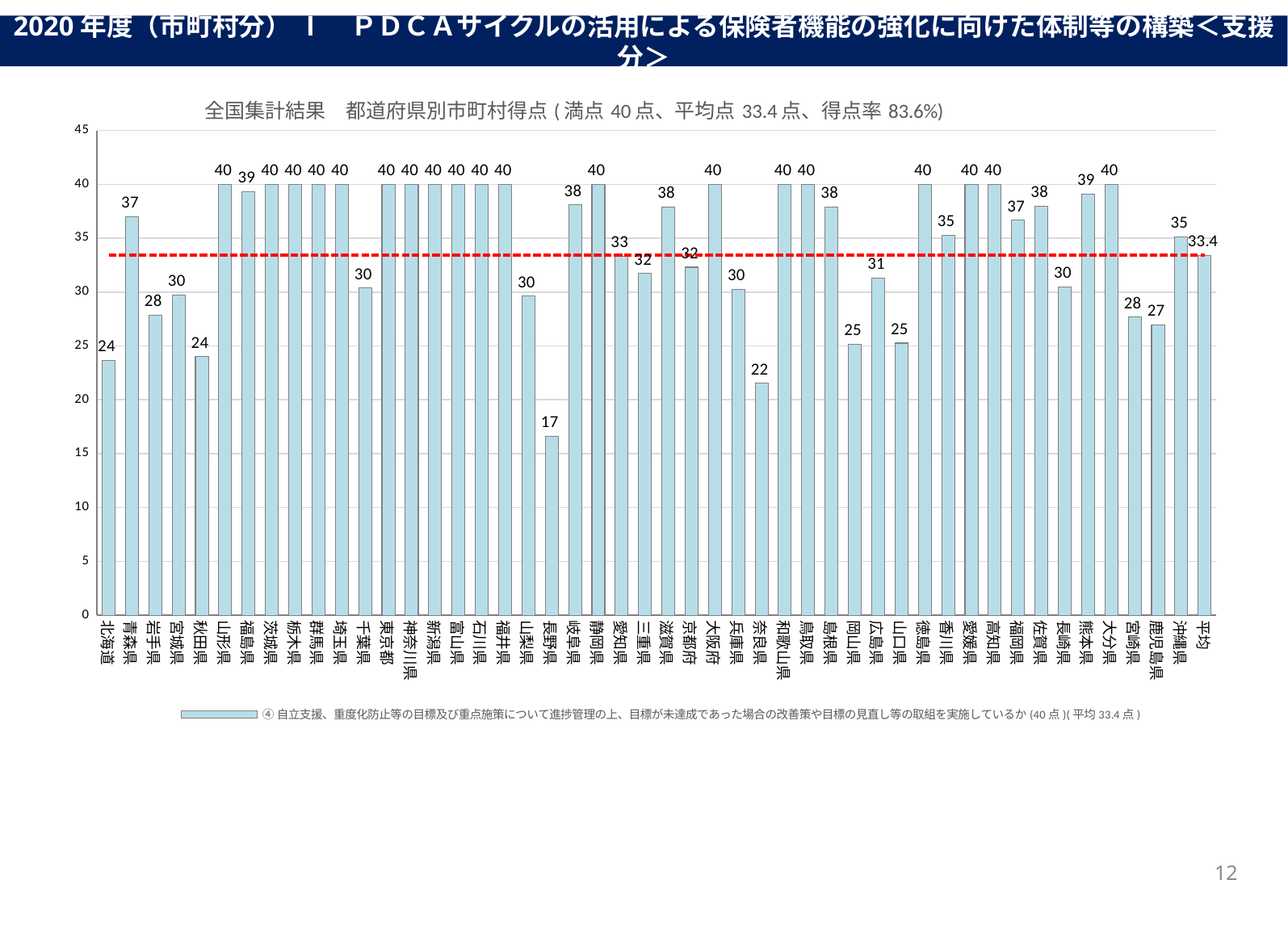
What kind of chart is shown on the slide? bar chart Which prefecture has the lowest value? 長野県 What is the value for 沖縄県? 35 What is the value for 奈良県? 22 What is the difference between the values for 青森県 and 北海道? 13 How many series does the legend list? 1 What is the 平均点 (average score) stated in the chart title? 33.4 点 How many bars are plotted in the chart (including 平均)? 48 Is the value for 広島県 greater or less than 35? less Which has a larger value, 岐阜県 or 愛知県? 岐阜県 What is the value for 長野県? 17 What is the value for 平均 (the last bar)? 33.4